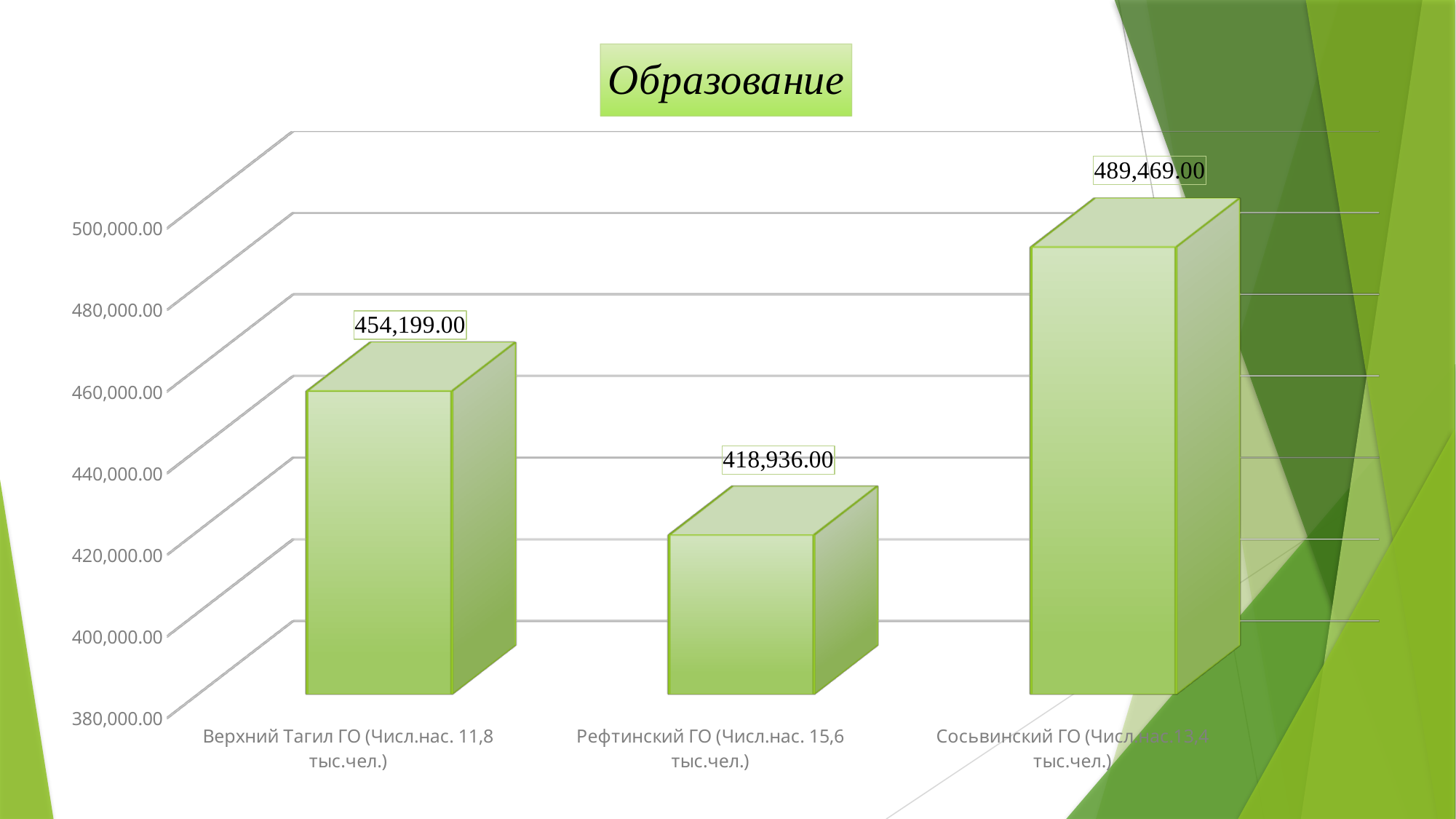
Is the value for Рефтинский ГО greater or less than 440,000.00? less What kind of chart is shown on the slide? bar chart What is the value for Сосьвинский ГО? 489,469.00 What is the value for Рефтинский ГО? 418,936.00 Which category has the highest value? Сосьвинский ГО What is the difference between the values for Сосьвинский ГО and Верхний Тагил ГО? 35,270.00 Which category has the lowest value? Рефтинский ГО What is the difference between the values for Верхний Тагил ГО and Рефтинский ГО? 35,263.00 What is the value for Верхний Тагил ГО? 454,199.00 What is the title of the chart? Образование How many categories are shown in the chart? 3 Which is larger, the value for Верхний Тагил ГО or the value for Рефтинский ГО? Верхний Тагил ГО